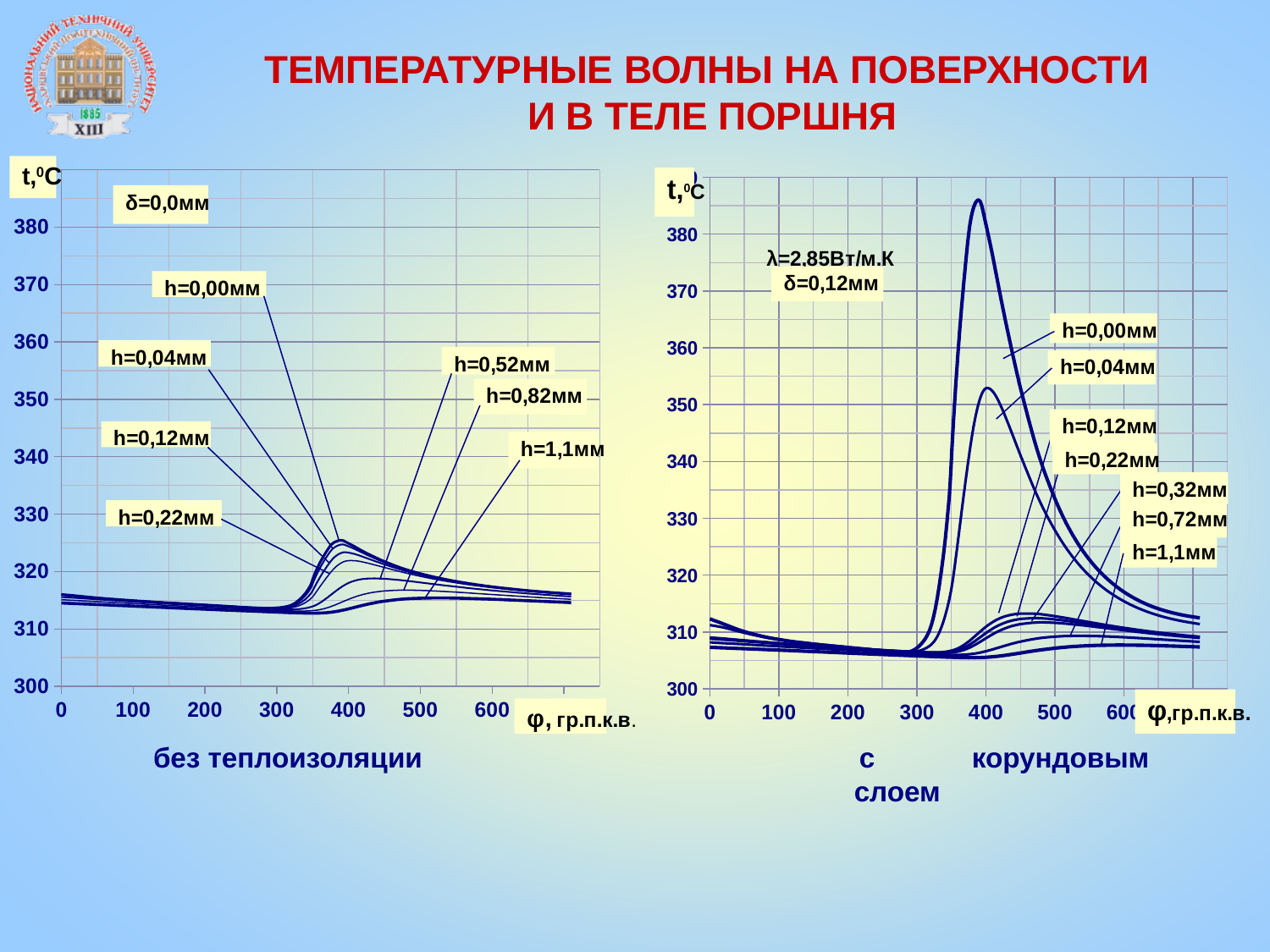
On the left chart ("без теплоизоляции"), is the peak value of the h=0,00мм curve greater or less than 320? greater On the left chart ("без теплоизоляции"), is the peak value of the h=0,00мм curve greater or less than 330? less What kind of chart is the left chart, labelled "без теплоизоляции"? line chart What is the label of the horizontal axis on the left chart ("без теплоизоляции")? φ, гр.п.к.в. Which chart shows the higher peak temperature for the h=0,00мм curve, the left ("без теплоизоляции") or the right ("с корундовым слоем")? the right chart (с корундовым слоем) On the right chart ("с корундовым слоем"), is the peak value of the h=0,00мм curve greater or less than 380? greater On the left chart ("без теплоизоляции"), which labelled curve reaches the highest temperature? h=0,00мм What value of δ is stated on the right chart ("с корундовым слоем")? δ=0,12мм On the right chart ("с корундовым слоем"), which labelled curve reaches the highest temperature? h=0,00мм How many h-curves are labelled on the right chart ("с корундовым слоем")? 7 How many h-curves are labelled on the left chart ("без теплоизоляции")? 7